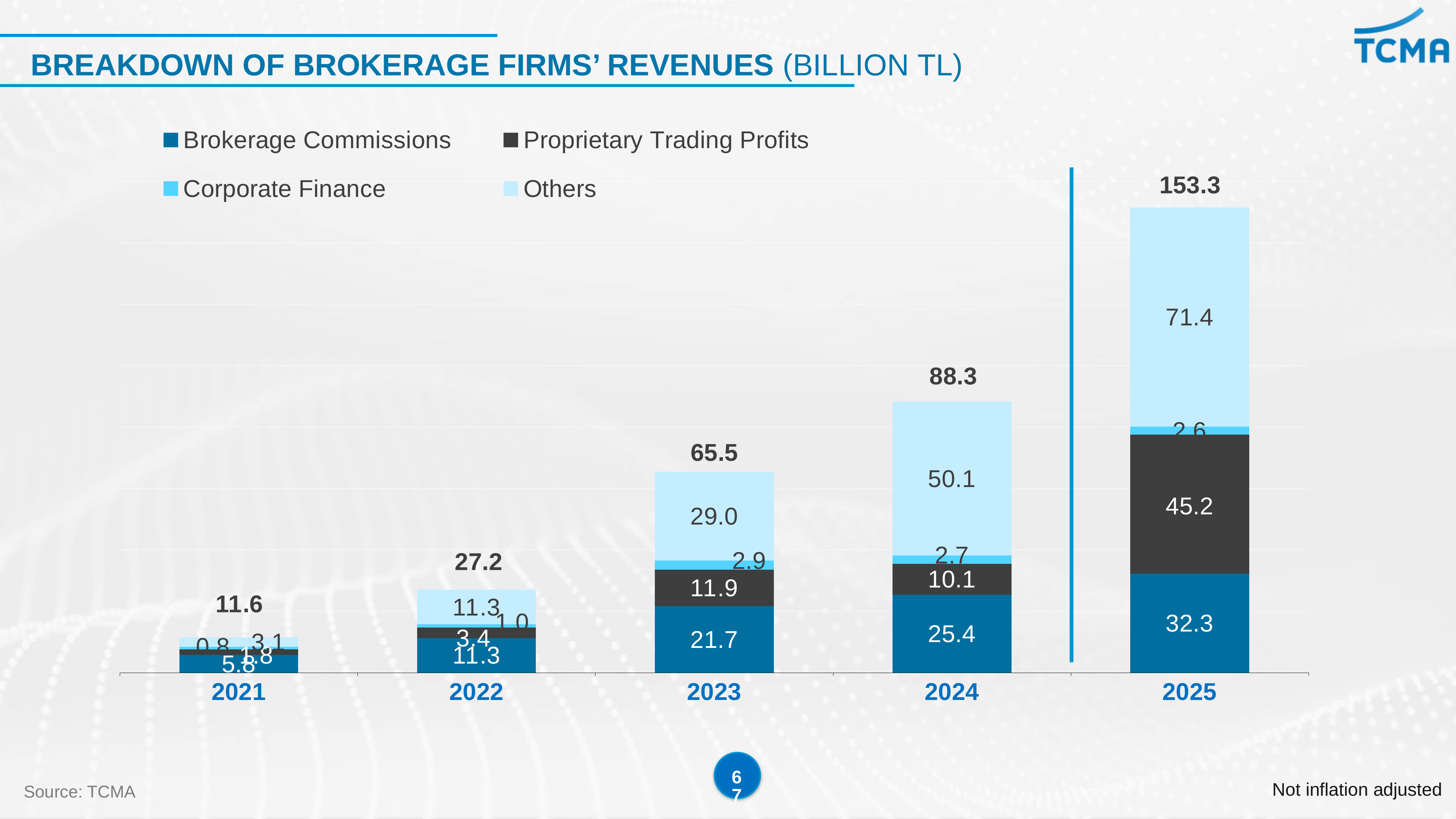
What is the value of Brokerage Commissions in 2024? 25.4 Which year has the lowest total revenue? 2021 What is the value of Proprietary Trading Profits in 2025? 45.2 What is the value of Corporate Finance in 2024? 2.7 How many series does the legend list? 4 What is the value of Others in 2023? 29.0 Do the total revenues rise or fall from 2021 to 2025? rise In 2025, which is larger: Proprietary Trading Profits or Brokerage Commissions? Proprietary Trading Profits What is the difference between the total revenue in 2025 and in 2024? 65.0 How many years are shown on the x axis? 5 What is the total revenue shown for 2025? 153.3 Which year has the highest total revenue? 2025